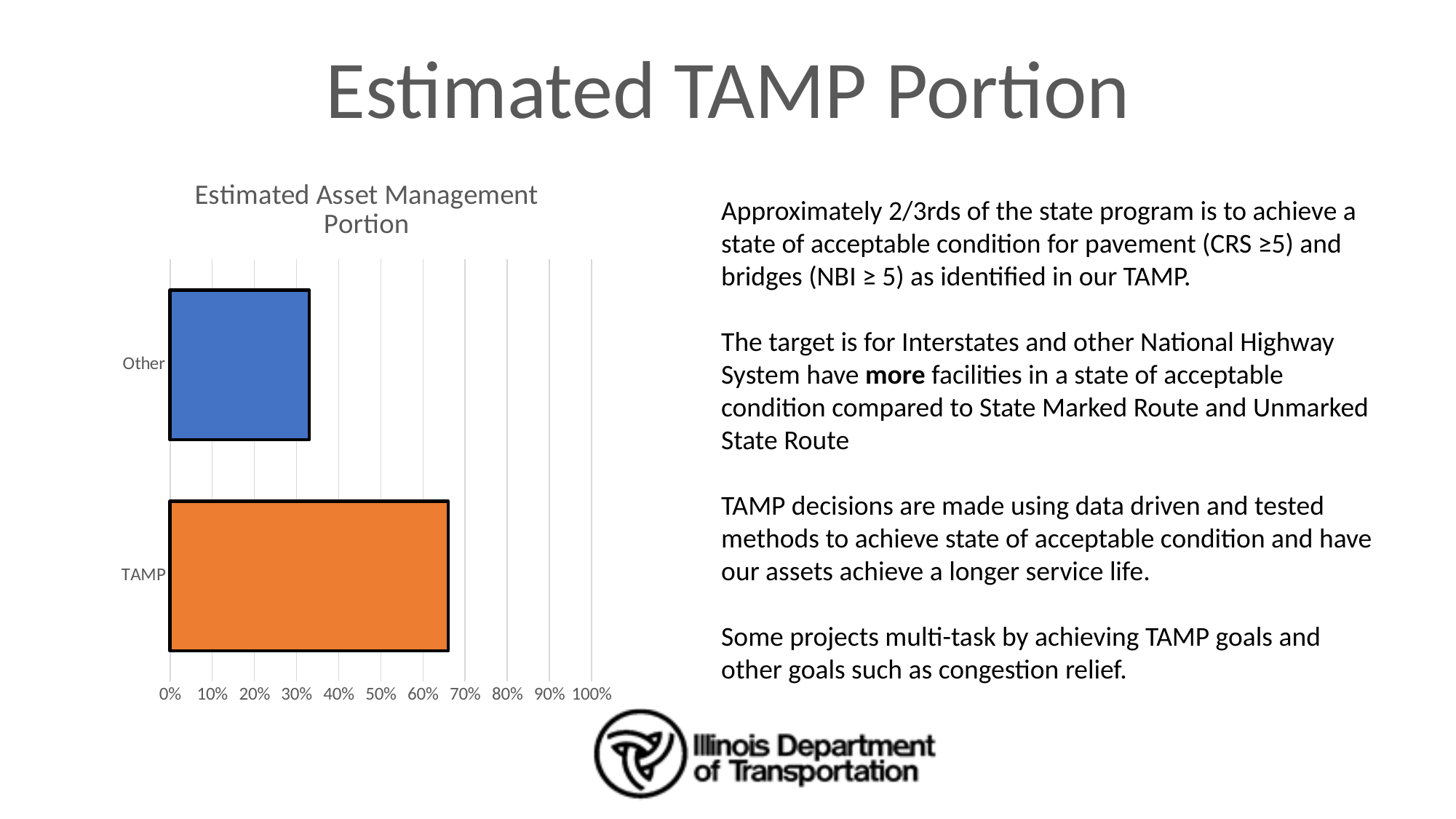
How many categories are plotted in the chart? 2 Which is larger, the value for TAMP or the value for Other? TAMP What is the title of the chart? Estimated Asset Management Portion What kind of chart is shown on the slide? bar chart Which category has the lowest value in the chart? Other What colour is the bar for TAMP? orange Is the value for Other greater or less than 20%? greater Is the value for TAMP greater or less than 70%? less Is the value for TAMP greater or less than 60%? greater What is the highest value shown on the horizontal axis of the chart? 100% Which category has the highest value in the chart? TAMP